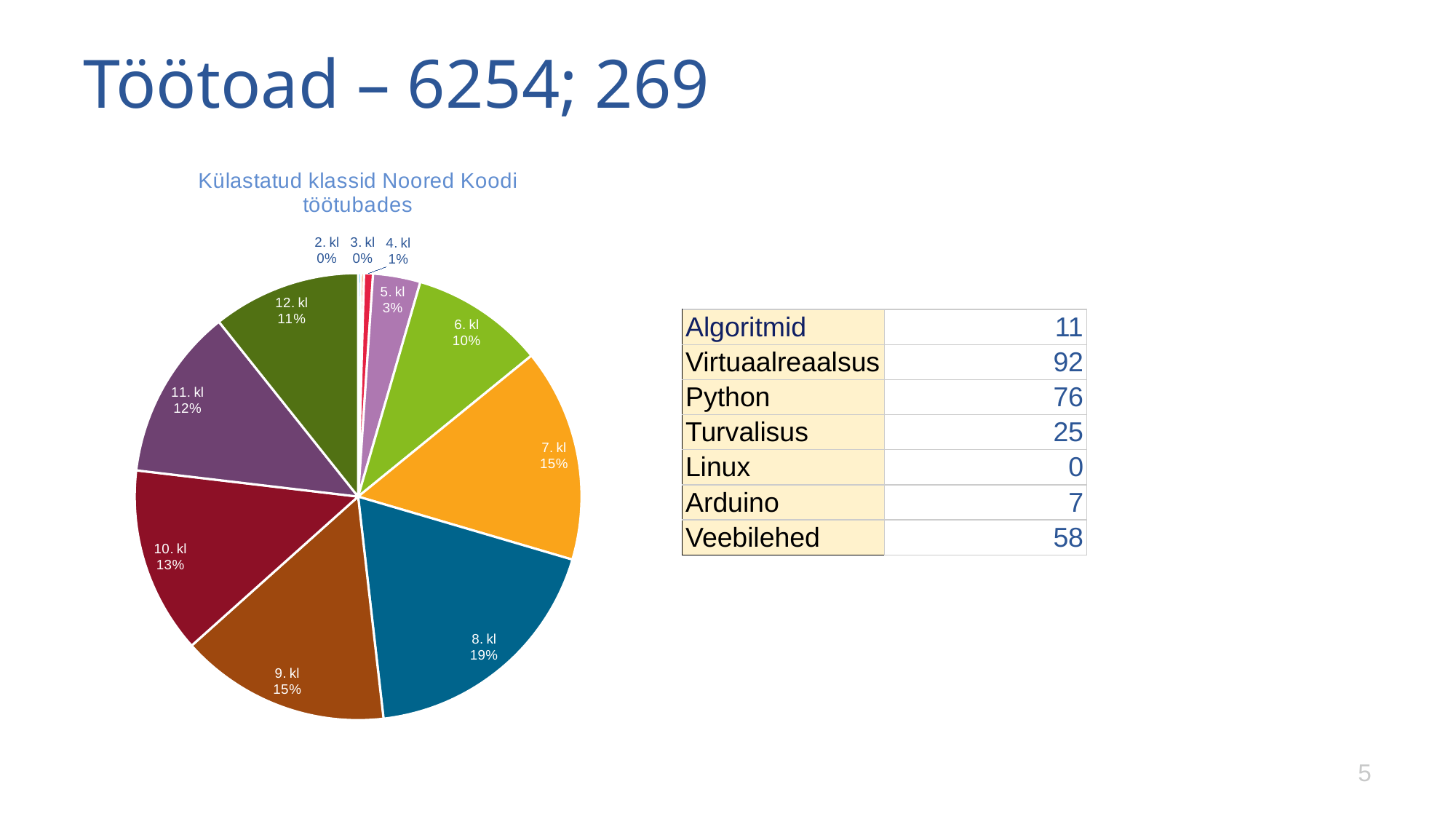
What is the combined share of 7. kl and 9. kl? 30% Which two classes are labelled with 0% in the pie chart? 2. kl and 3. kl What is the difference in percentage points between 8. kl and 6. kl? 9 What is the title of the pie chart? Külastatud klassid Noored Koodi töötubades What percentage is shown for 12. kl? 11% What percentage is shown for 6. kl? 10% Which is larger, the share for 10. kl or the share for 11. kl? 10. kl Which class has the largest slice of the pie? 8. kl What kind of chart is shown on the slide? pie chart What share of the pie does 8. kl have? 19% How many slices (classes) does the pie chart have? 11 What percentage is shown for 5. kl? 3%